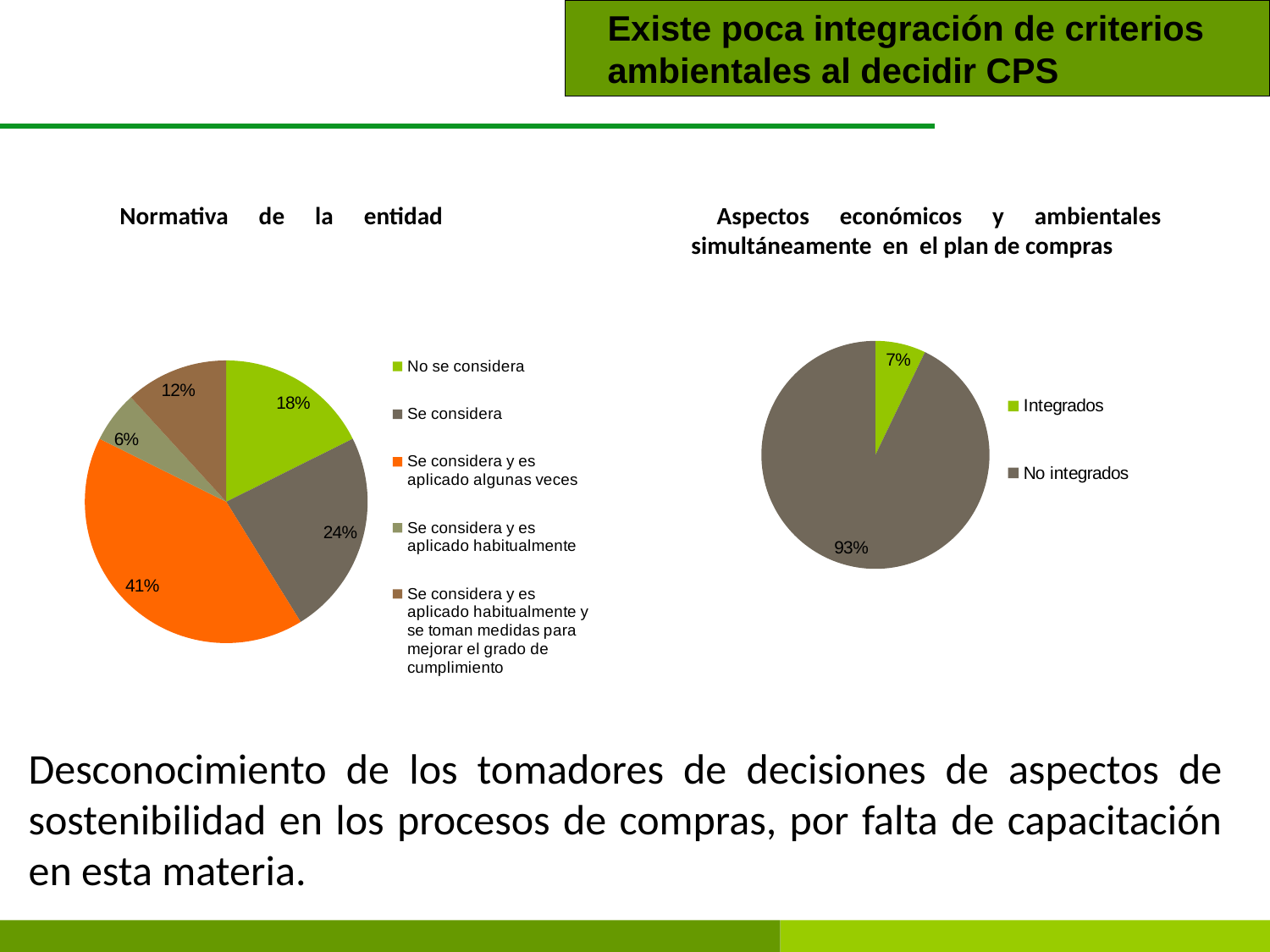
In the 'Normativa de la entidad' chart, what is the difference between the 'Se considera y es aplicado algunas veces' slice and the 'Se considera' slice? 17% In the 'Normativa de la entidad' chart, what share is labelled for 'Se considera y es aplicado algunas veces'? 41% In the 'Normativa de la entidad' chart, which category has the largest slice? Se considera y es aplicado algunas veces What kind of chart is the 'Normativa de la entidad' chart? Pie chart In the 'Aspectos económicos y ambientales simultáneamente en el plan de compras' chart, what share is labelled for 'Integrados'? 7% In the 'Aspectos económicos y ambientales simultáneamente en el plan de compras' chart, which is larger, 'Integrados' or 'No integrados'? No integrados In the 'Normativa de la entidad' chart, which category has the smallest slice? Se considera y es aplicado habitualmente In the 'Aspectos económicos y ambientales simultáneamente en el plan de compras' chart, how many categories does the legend list? 2 In the 'Normativa de la entidad' chart, what share is labelled for 'Se considera'? 24% In the 'Normativa de la entidad' chart, how many categories does the legend list? 5 In the 'Normativa de la entidad' chart, what share is labelled for 'No se considera'? 18% In the 'Aspectos económicos y ambientales simultáneamente en el plan de compras' chart, what share is labelled for 'No integrados'? 93%